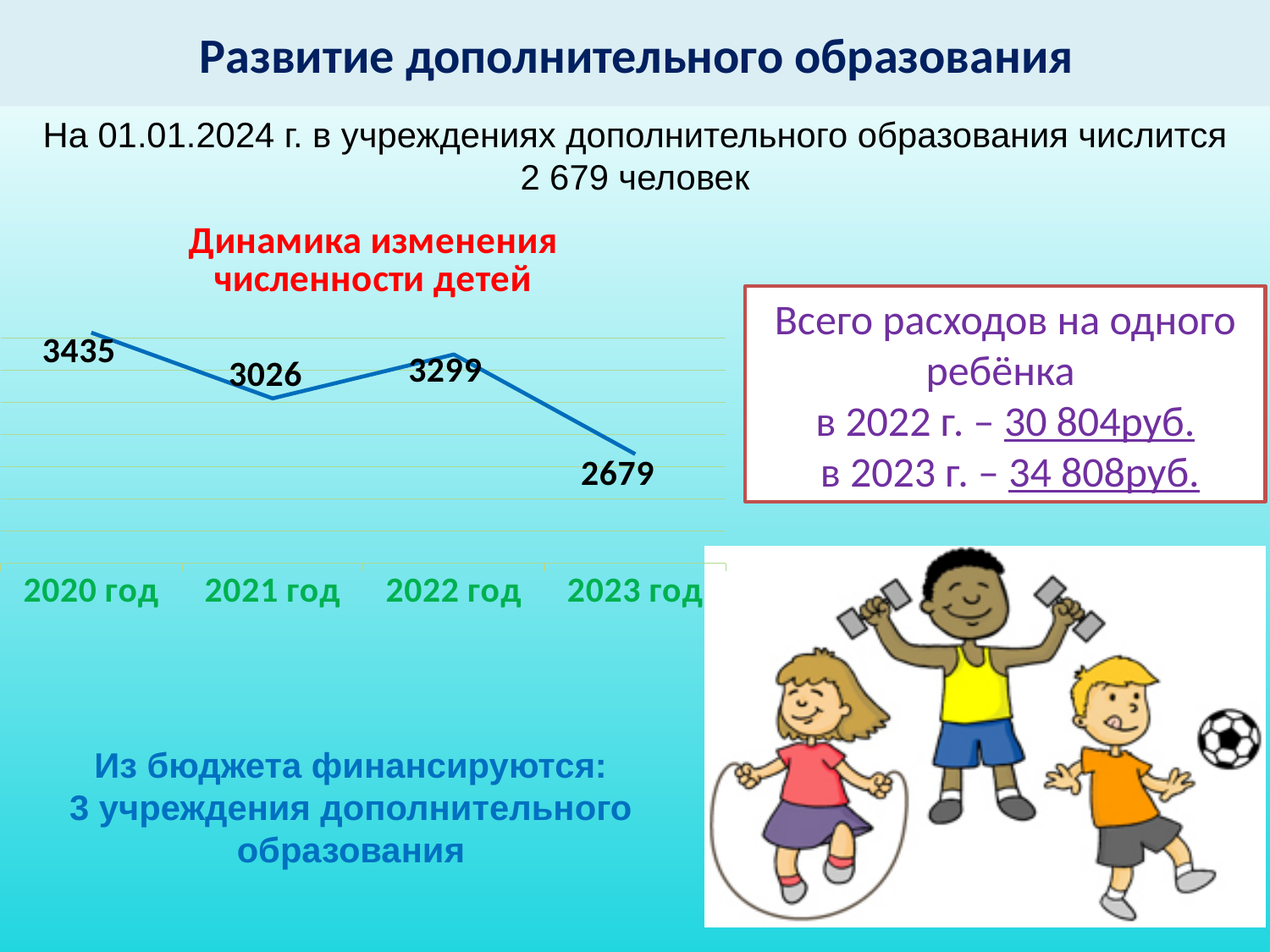
What is the value for 2020 год in the chart 'Динамика изменения численности детей'? 3435 What is the value for 2021 год in the chart 'Динамика изменения численности детей'? 3026 How many years are plotted in the chart 'Динамика изменения численности детей'? 4 Does the value in the chart 'Динамика изменения численности детей' rise or fall from 2022 год to 2023 год? Fall Which year has the lowest value in the chart 'Динамика изменения численности детей'? 2023 год Which year has the highest value in the chart 'Динамика изменения численности детей'? 2020 год What is the difference between the values for 2020 год and 2023 год in the chart 'Динамика изменения численности детей'? 756 What is the value for 2022 год in the chart 'Динамика изменения численности детей'? 3299 What kind of chart is 'Динамика изменения численности детей'? Line chart Which is larger in the chart 'Динамика изменения численности детей': the value for 2021 год or 2022 год? 2022 год What is the difference between the values for 2022 год and 2021 год in the chart 'Динамика изменения численности детей'? 273 What is the value for 2023 год in the chart 'Динамика изменения численности детей'? 2679